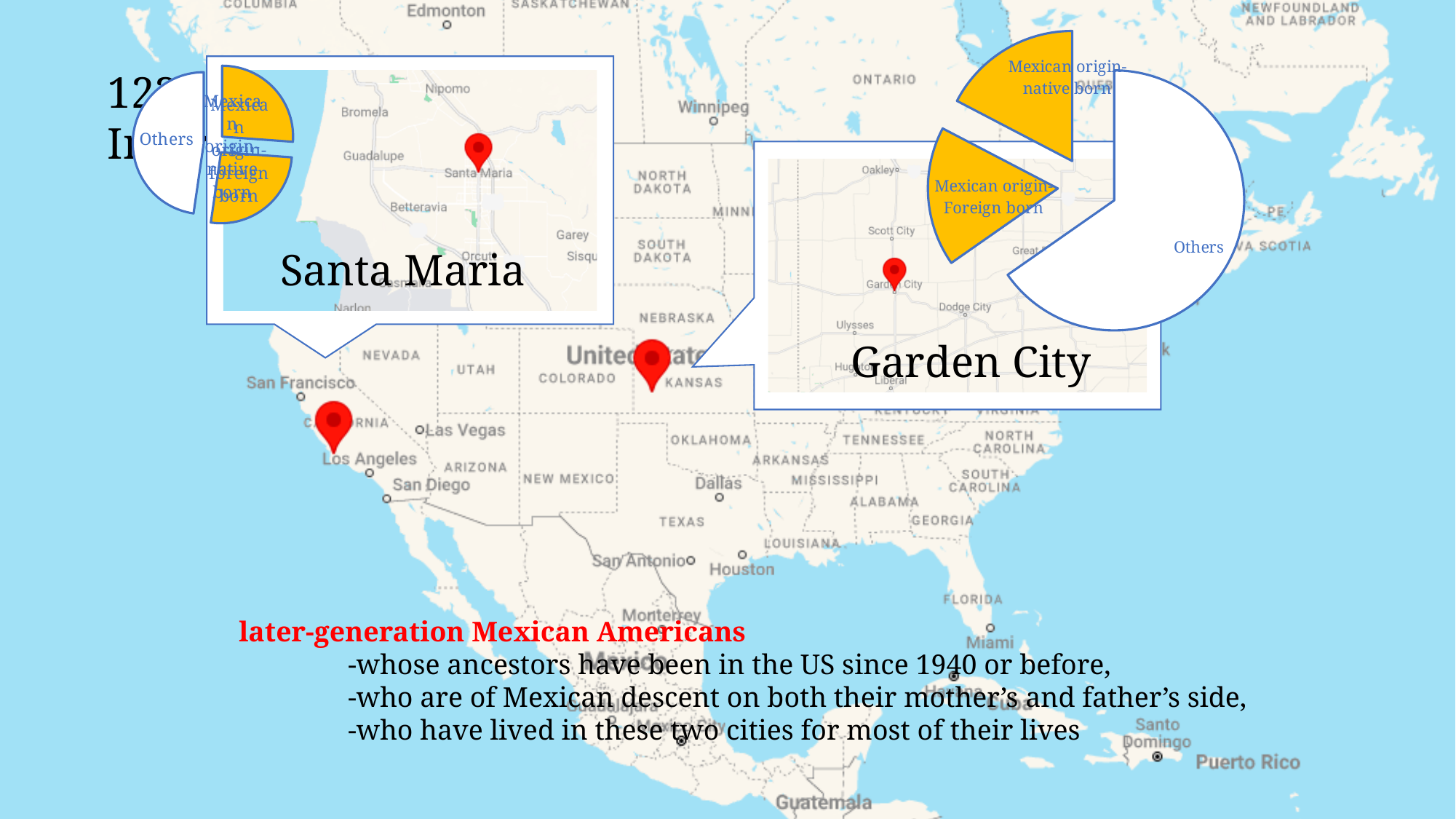
In the pie chart next to the Santa Maria map, which slice is the largest? Others In the pie chart next to the Garden City map, what colour is the Others slice? White In the pie chart next to the Garden City map, what colour are the Mexican origin slices? Yellow In the pie chart next to the Garden City map, is the Others slice more or less than half of the pie? More In the pie chart next to the Garden City map, is the Others slice larger or smaller than the Mexican origin-Foreign born slice? Larger In the pie chart next to the Santa Maria map, how many slices are there? 3 In the pie chart next to the Garden City map, which slice is the largest? Others In the pie chart next to the Garden City map, how many slices are there? 3 What kind of chart is shown next to the Santa Maria map? Pie chart What kind of chart is shown next to the Garden City map? Pie chart